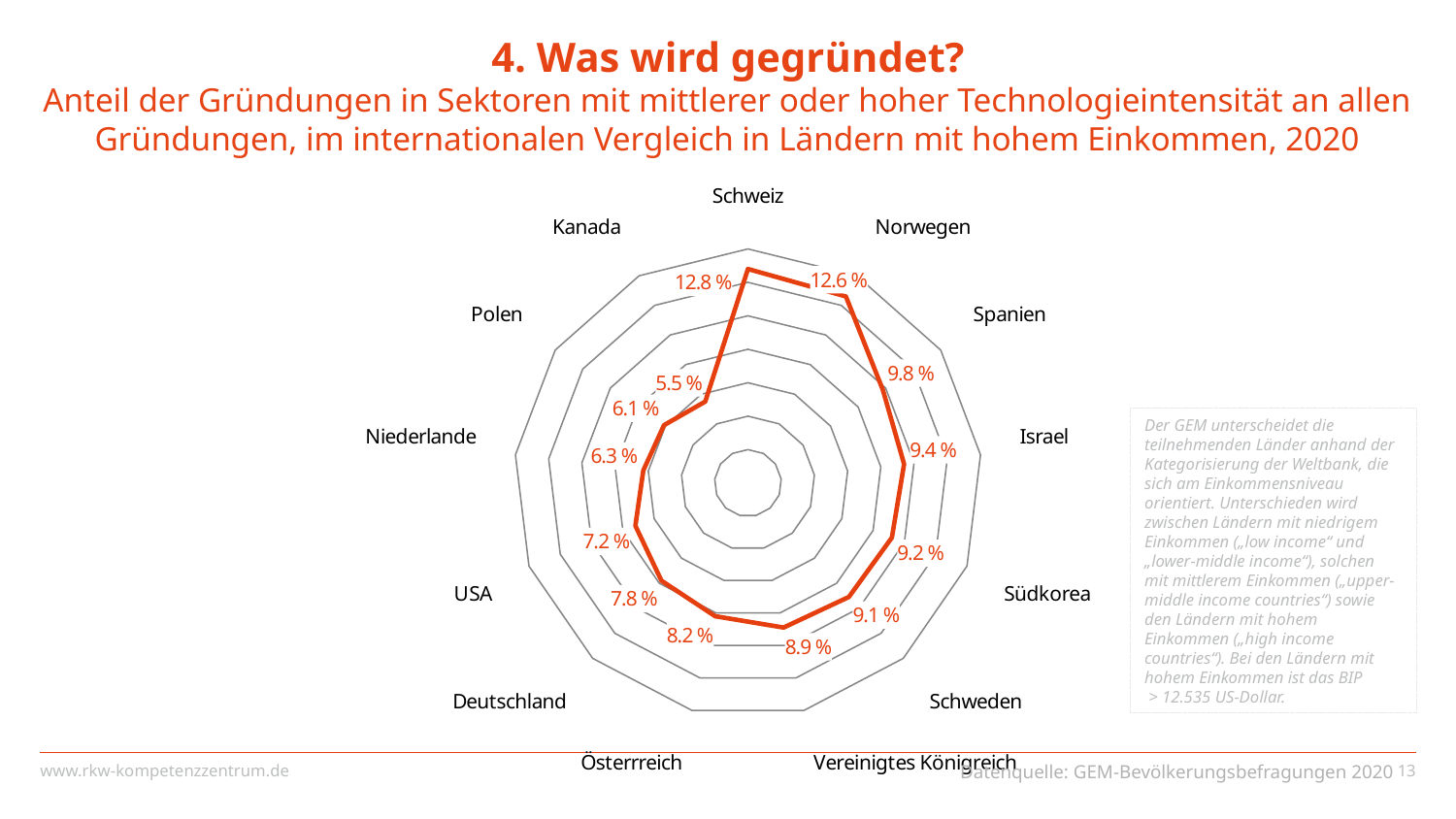
Which country has the lowest share of start-ups in medium- or high-technology sectors? Kanada Which country has the highest share of start-ups in medium- or high-technology sectors? Schweiz What is the data source named at the bottom of the slide? GEM-Bevölkerungsbefragungen 2020 What is the difference between the values for Schweiz and Kanada? 7.3 percentage points What is the value shown for Norwegen? 12.6 % What is the value shown for Deutschland? 7.8 % What is the difference between the values for Österreich and Niederlande? 1.9 percentage points Which has the larger value, Spanien or Schweden? Spanien What is the value shown for Israel? 9.4 % What is the value shown for USA? 7.2 % How many countries are plotted on the radar chart? 13 What kind of chart is shown on the slide? Radar chart